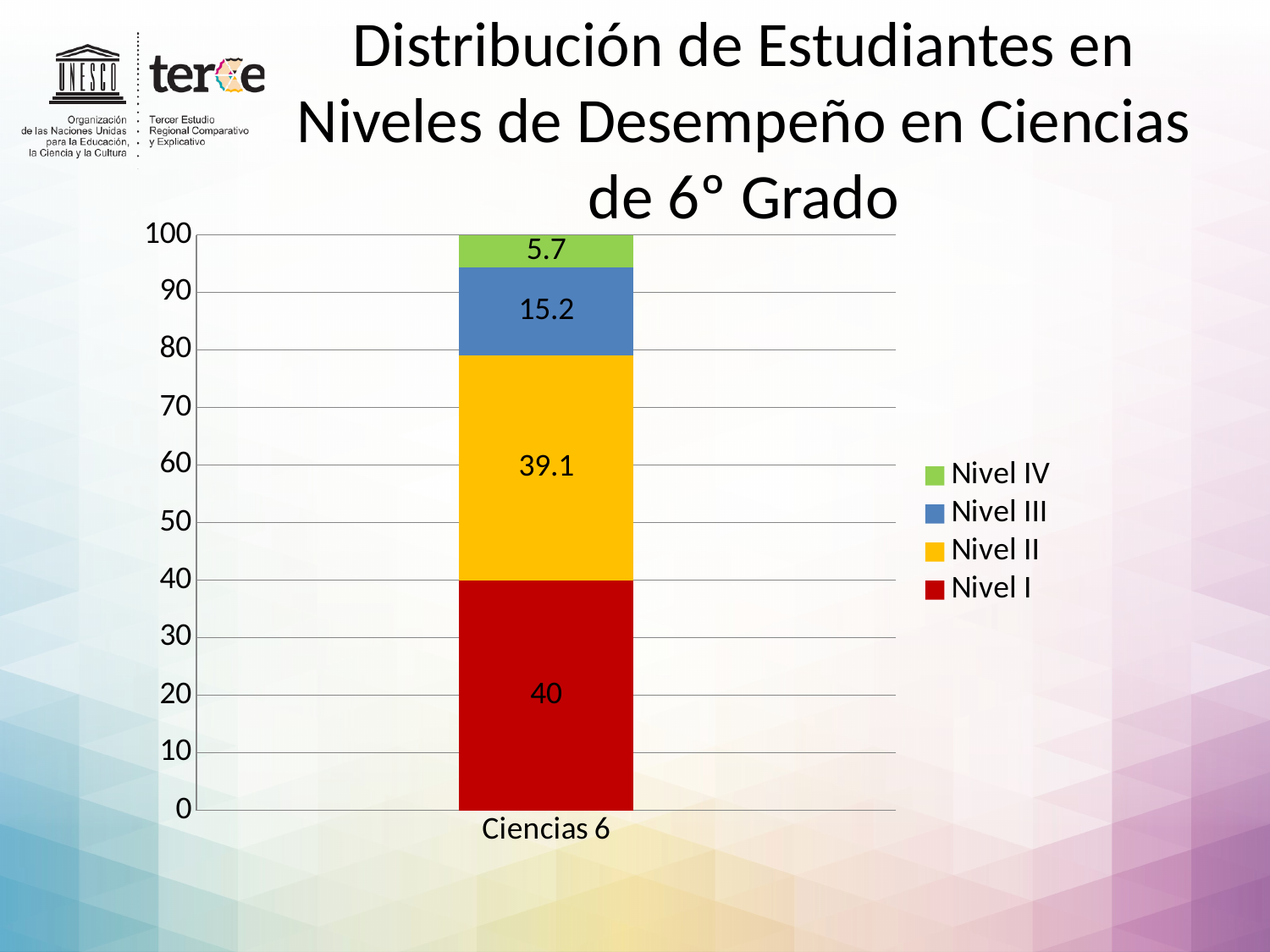
What is the difference between the Nivel II and Nivel III values? 23.9 What colour represents Nivel II in the chart? Yellow What is the value for Nivel I in the Ciencias 6 bar? 40 Which level has the largest share of students in the Ciencias 6 bar? Nivel I What kind of chart is shown on the slide? Stacked bar chart Which level has the smallest share of students in the Ciencias 6 bar? Nivel IV How many series does the legend list? 4 Which is larger, the value for Nivel III or the value for Nivel IV? Nivel III What is the value for Nivel II in the Ciencias 6 bar? 39.1 What is the value for Nivel III in the Ciencias 6 bar? 15.2 What is the total of the stacked bar for Ciencias 6? 100 What is the value for Nivel IV in the Ciencias 6 bar? 5.7